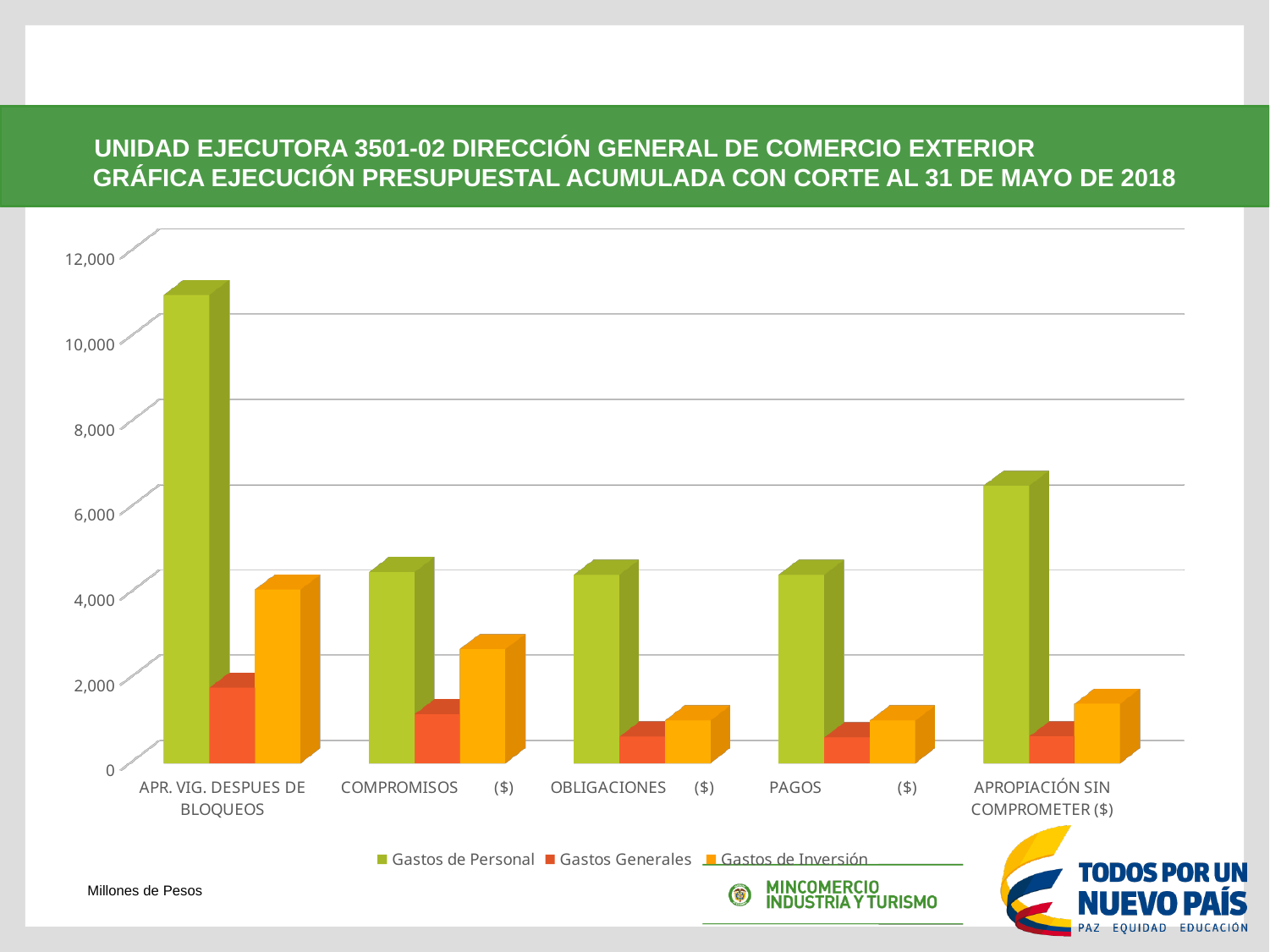
How many series does the legend list? 3 Which is larger in PAGOS ($): Gastos de Personal or Gastos de Inversión? Gastos de Personal Is the value for Gastos de Personal in APR. VIG. DESPUES DE BLOQUEOS greater or less than 10,000? greater Which category has the highest value for Gastos de Inversión? APR. VIG. DESPUES DE BLOQUEOS Which is larger in APR. VIG. DESPUES DE BLOQUEOS: Gastos Generales or Gastos de Inversión? Gastos de Inversión Is the value for Gastos de Inversión in COMPROMISOS ($) greater or less than 2,000? greater Is the value for Gastos de Personal in APROPIACIÓN SIN COMPROMETER ($) greater or less than 6,000? greater How many categories are shown along the x axis? 5 Which category has the highest value for Gastos de Personal? APR. VIG. DESPUES DE BLOQUEOS Which colour represents Gastos Generales in the legend? orange-red What kind of chart is shown on the slide? bar chart